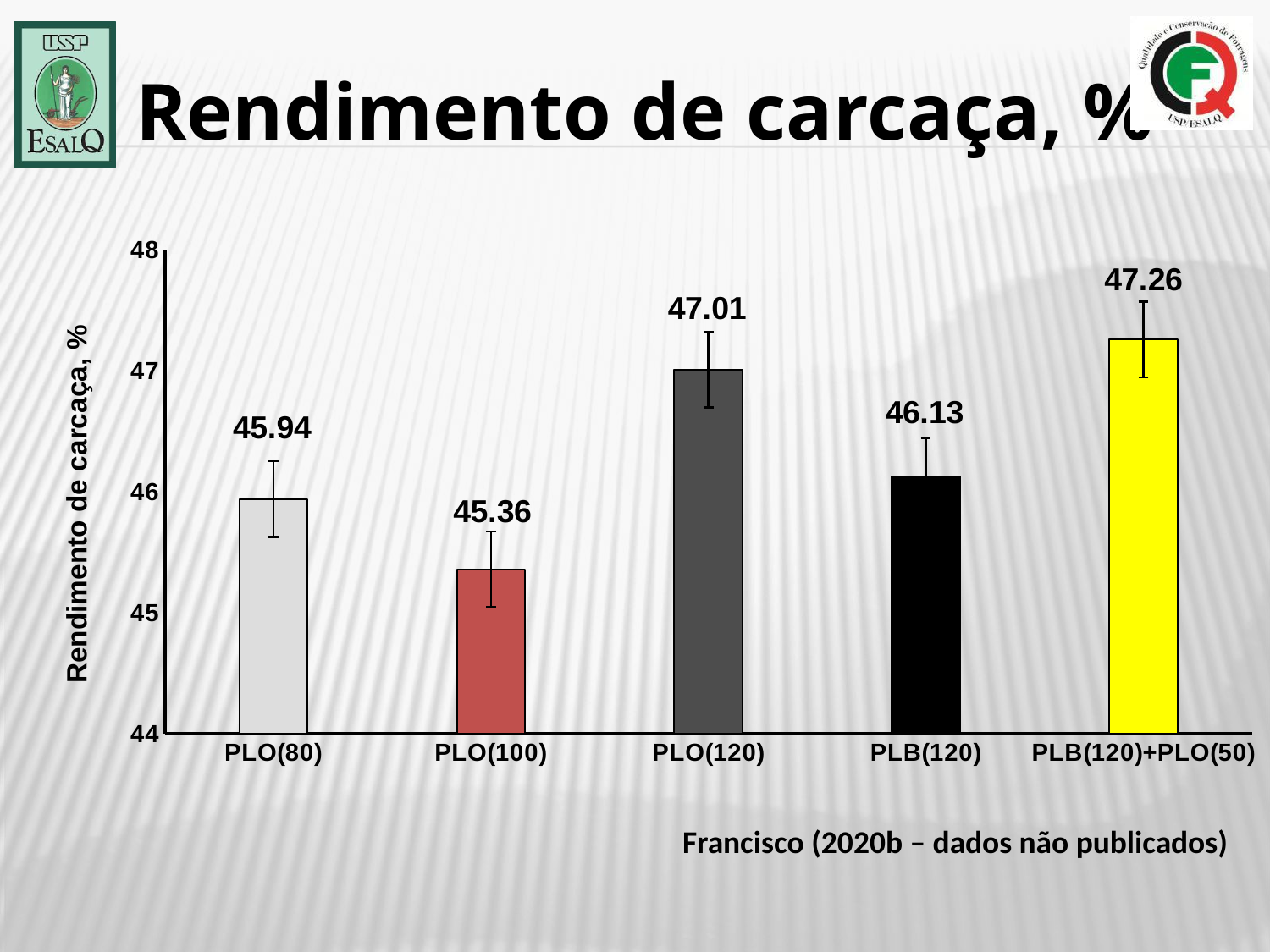
What colour is the bar for PLB(120)+PLO(50)? yellow Is the value for PLO(120) greater or less than 46? greater What is the value for PLO(100)? 45.36 What is the label of the y axis? Rendimento de carcaça, % Which category has the highest value? PLB(120)+PLO(50) What is the value for PLO(80)? 45.94 What is the value for PLB(120)+PLO(50)? 47.26 How many categories are shown on the x axis? 5 Which is larger, the value for PLO(80) or the value for PLB(120)? PLB(120) What kind of chart is shown on the slide? bar chart What is the difference between the values for PLO(120) and PLB(120)? 0.88 Which category has the lowest value? PLO(100)